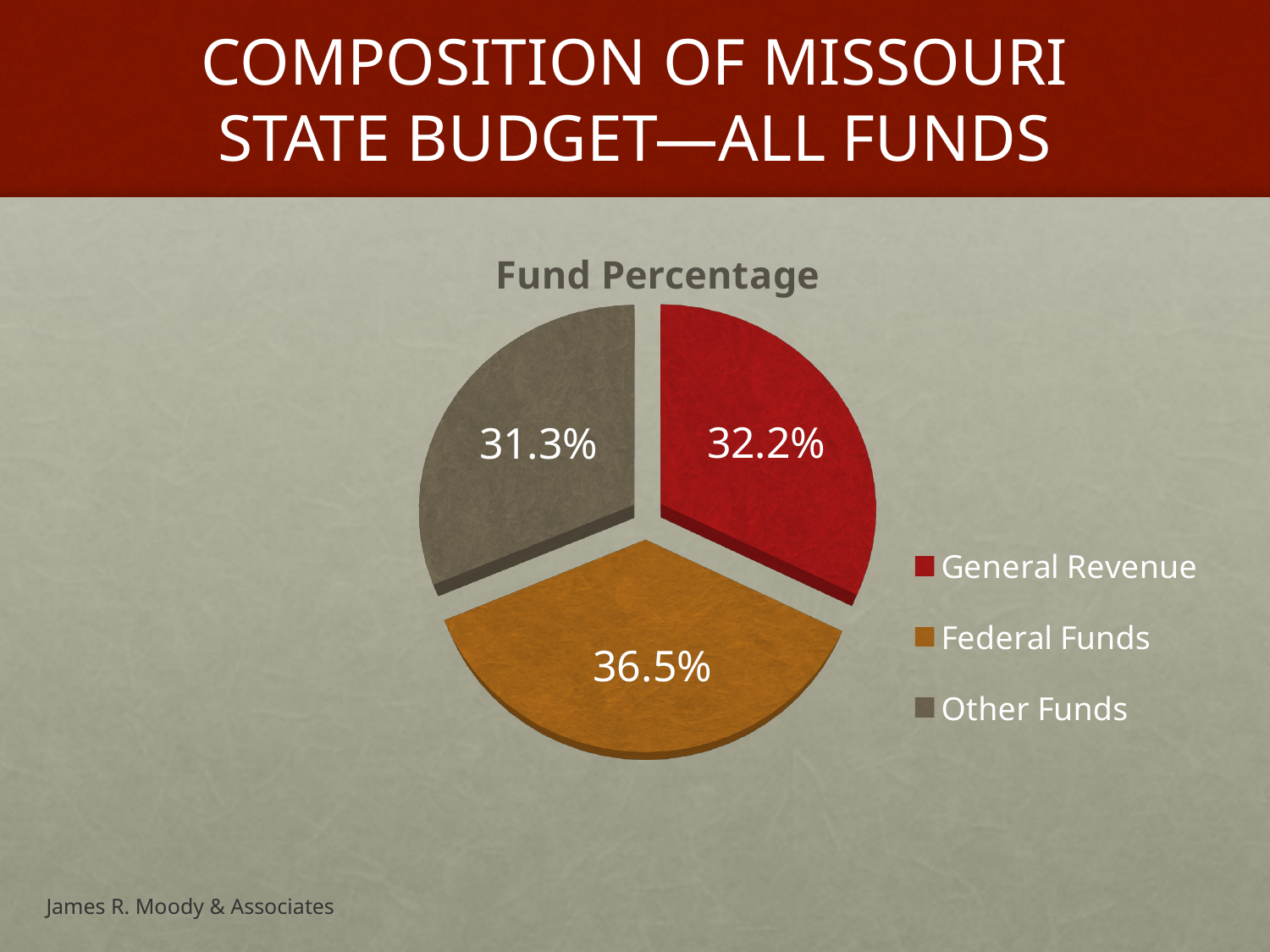
How many fund categories are shown in the pie chart? 3 What is the difference in percentage points between Federal Funds and General Revenue? 4.3 What is the title of the chart? Fund Percentage Which fund source has the largest share of the budget? Federal Funds What kind of chart is shown on the slide? Pie chart What is the difference in percentage points between General Revenue and Other Funds? 0.9 What percentage of the budget comes from Federal Funds? 36.5% What percentage of the budget comes from Other Funds? 31.3% What percentage of the budget comes from General Revenue? 32.2% Which fund source has the smallest share of the budget? Other Funds Which colour represents Federal Funds in the chart? Orange Which is larger, the share for Federal Funds or the share for Other Funds? Federal Funds